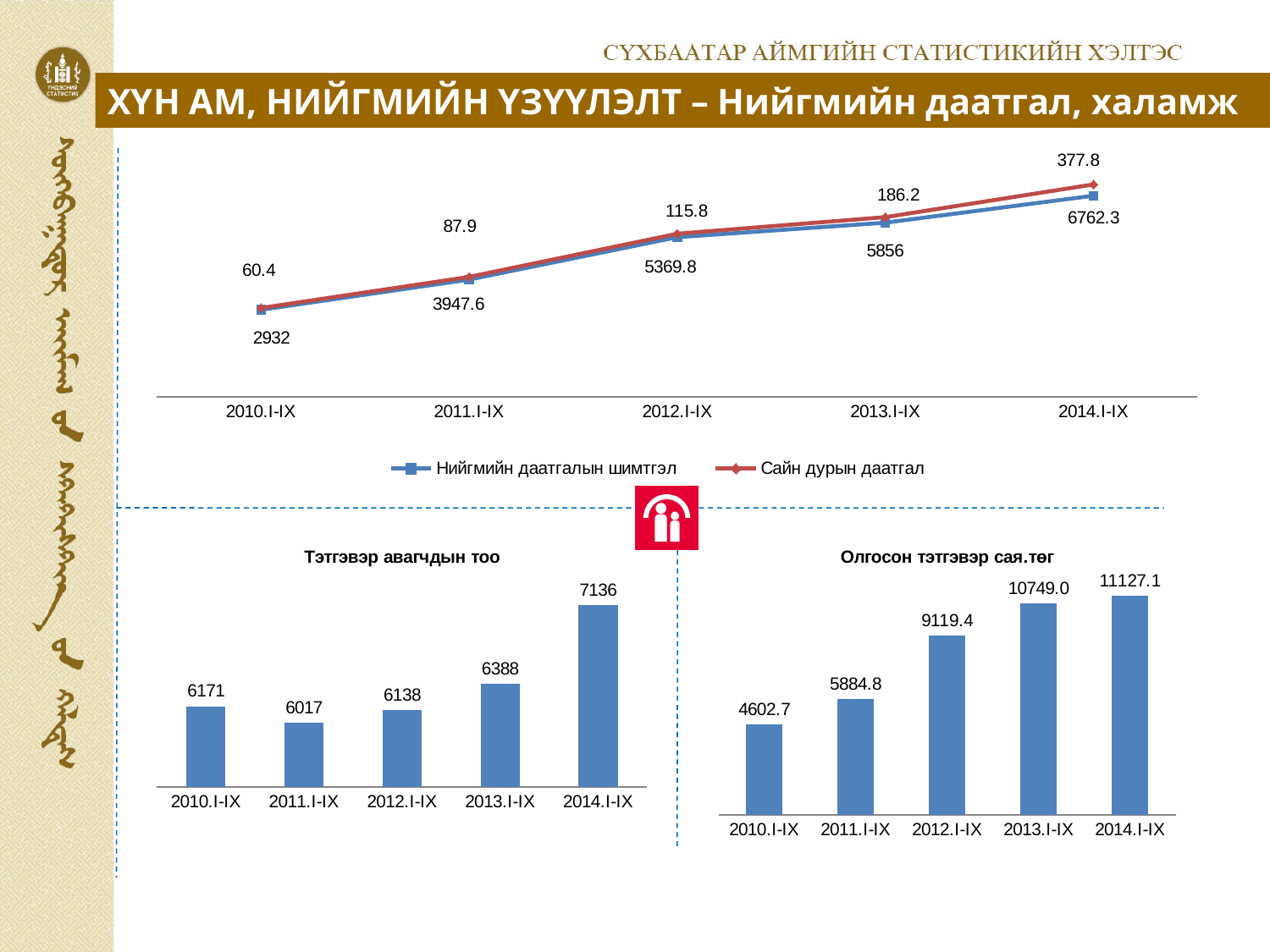
In the top line chart, what is the value of Нийгмийн даатгалын шимтгэл for 2014.I-IX? 6762.3 In the top line chart, what is the difference between the Сайн дурын даатгал values for 2014.I-IX and 2013.I-IX? 191.6 In the chart titled Тэтгэвэр авагчдын тоо, which period has the highest value? 2014.I-IX In the chart titled Тэтгэвэр авагчдын тоо, what is the value for 2013.I-IX? 6388 In the chart titled Олгосон тэтгэвэр сая.төг, what is the value for 2010.I-IX? 4602.7 In the top line chart, how many series does the legend list? 2 What kind of chart is the chart titled Олгосон тэтгэвэр сая.төг? bar chart In the chart titled Тэтгэвэр авагчдын тоо, what is the difference between the values for 2014.I-IX and 2013.I-IX? 748 In the top line chart, what is the value of Сайн дурын даатгал for 2012.I-IX? 115.8 In the chart titled Олгосон тэтгэвэр сая.төг, how many periods are shown on the x axis? 5 In the top line chart, do the values of Нийгмийн даатгалын шимтгэл rise or fall from 2010.I-IX to 2014.I-IX? rise In the chart titled Тэтгэвэр авагчдын тоо, which period has the lowest value? 2011.I-IX